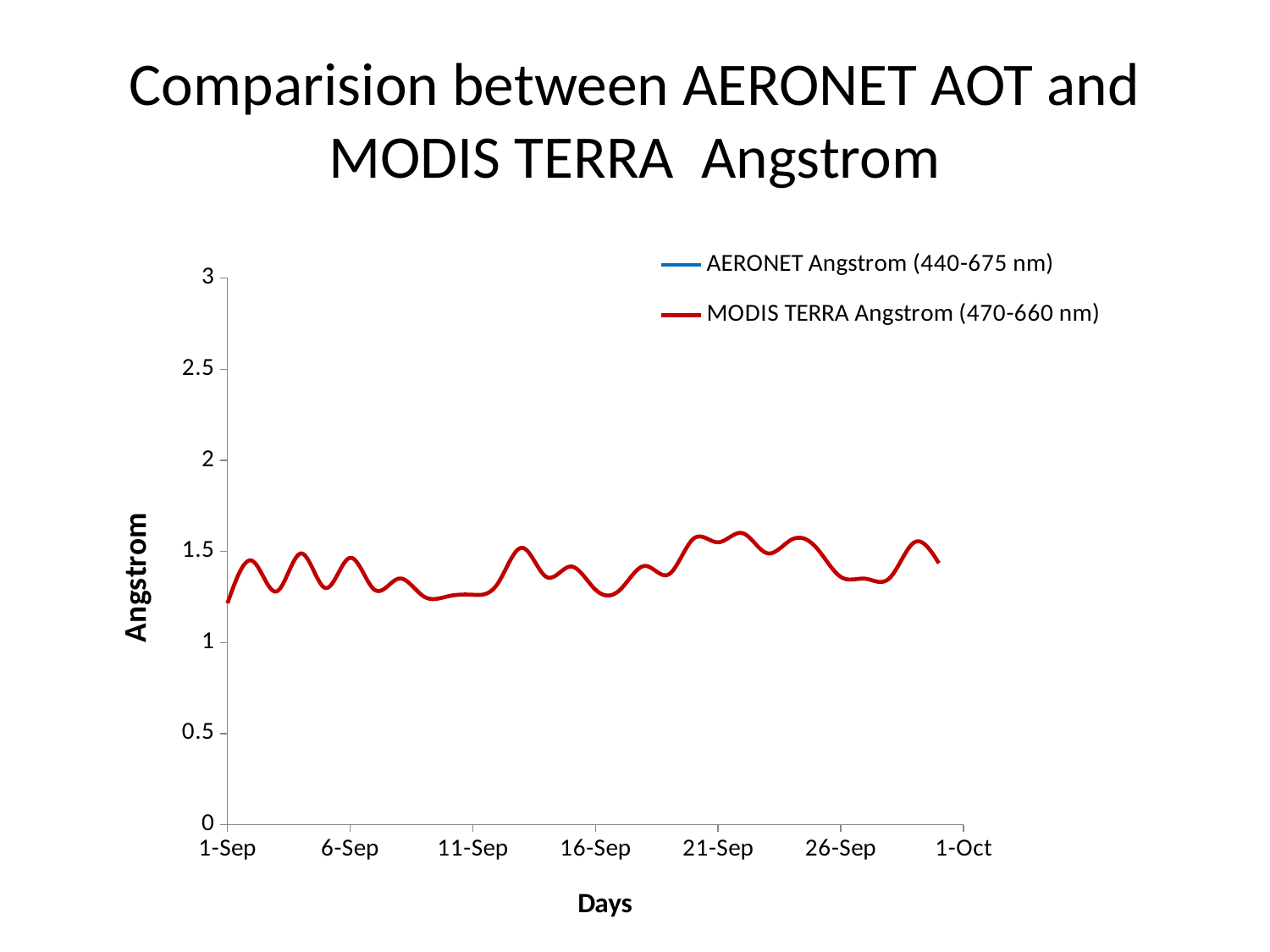
What is the first date label on the horizontal axis? 1-Sep Is the MODIS TERRA Angstrom value on 21-Sep greater or less than 2? less What colour is the MODIS TERRA Angstrom (470-660 nm) line in the legend? red Is the MODIS TERRA Angstrom value on 1-Sep greater or less than 1.5? less What is the highest value shown on the vertical axis? 3 What is the label of the horizontal axis? Days What kind of chart is shown on the slide? line chart What is the label of the vertical axis? Angstrom Is the MODIS TERRA Angstrom value on 1-Sep greater or less than 1? greater How many series does the legend list? 2 What is the title of the chart on the slide? Comparision between AERONET AOT and MODIS TERRA Angstrom